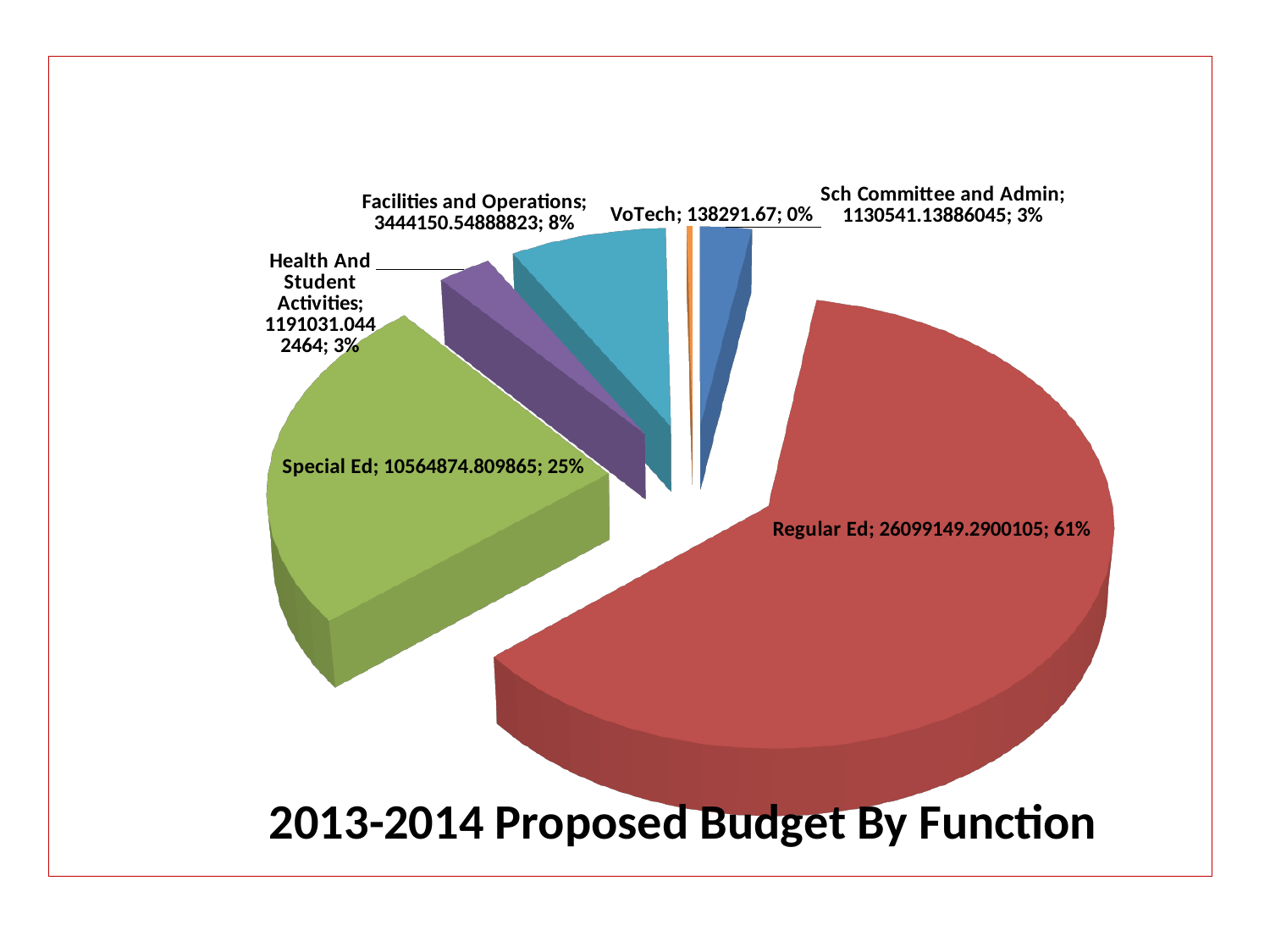
What is the value shown for Regular Ed? 26099149.2900105 What is the value shown for Sch Committee and Admin? 1130541.13886045 By how many percentage points does Regular Ed's share exceed Special Ed's share? 36 percentage points What kind of chart is shown on the slide? Pie chart What percentage of the budget goes to Special Ed? 25% What is the value shown for VoTech? 138291.67 Which has the larger value, Health And Student Activities or Sch Committee and Admin? Health And Student Activities How many slices does the pie chart have? 6 What percentage of the budget goes to Facilities and Operations? 8% What is the title of the chart? 2013-2014 Proposed Budget By Function Which function has the largest share of the proposed budget? Regular Ed Which function has the smallest share of the proposed budget? VoTech